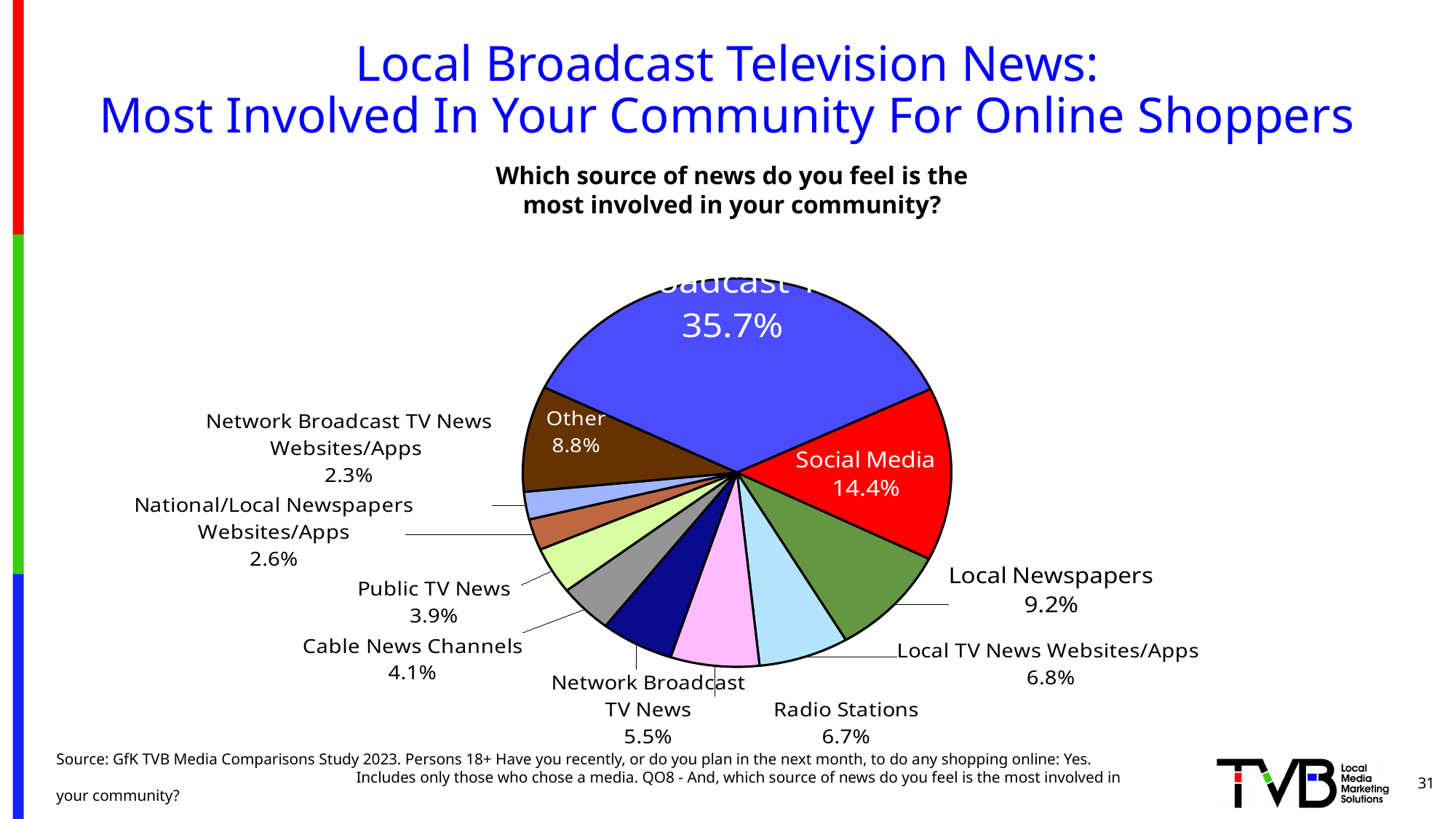
Which is larger, Local TV News Websites/Apps or Network Broadcast TV News? Local TV News Websites/Apps What is the difference between the Social Media share and the Local Newspapers share? 5.2% What is the value for Network Broadcast TV News Websites/Apps? 2.3% How many slices does the pie chart have? 11 What is the value for Radio Stations? 6.7% What is the largest percentage shown on the pie chart? 35.7% What percentage is shown for Local Newspapers? 9.2% Which category has the smallest share of the pie? Network Broadcast TV News Websites/Apps What kind of chart is shown on the slide? pie chart What share of the pie is Social Media? 14.4% What percentage is shown for Cable News Channels? 4.1% What question is shown as the chart's heading above the pie? Which source of news do you feel is the most involved in your community?